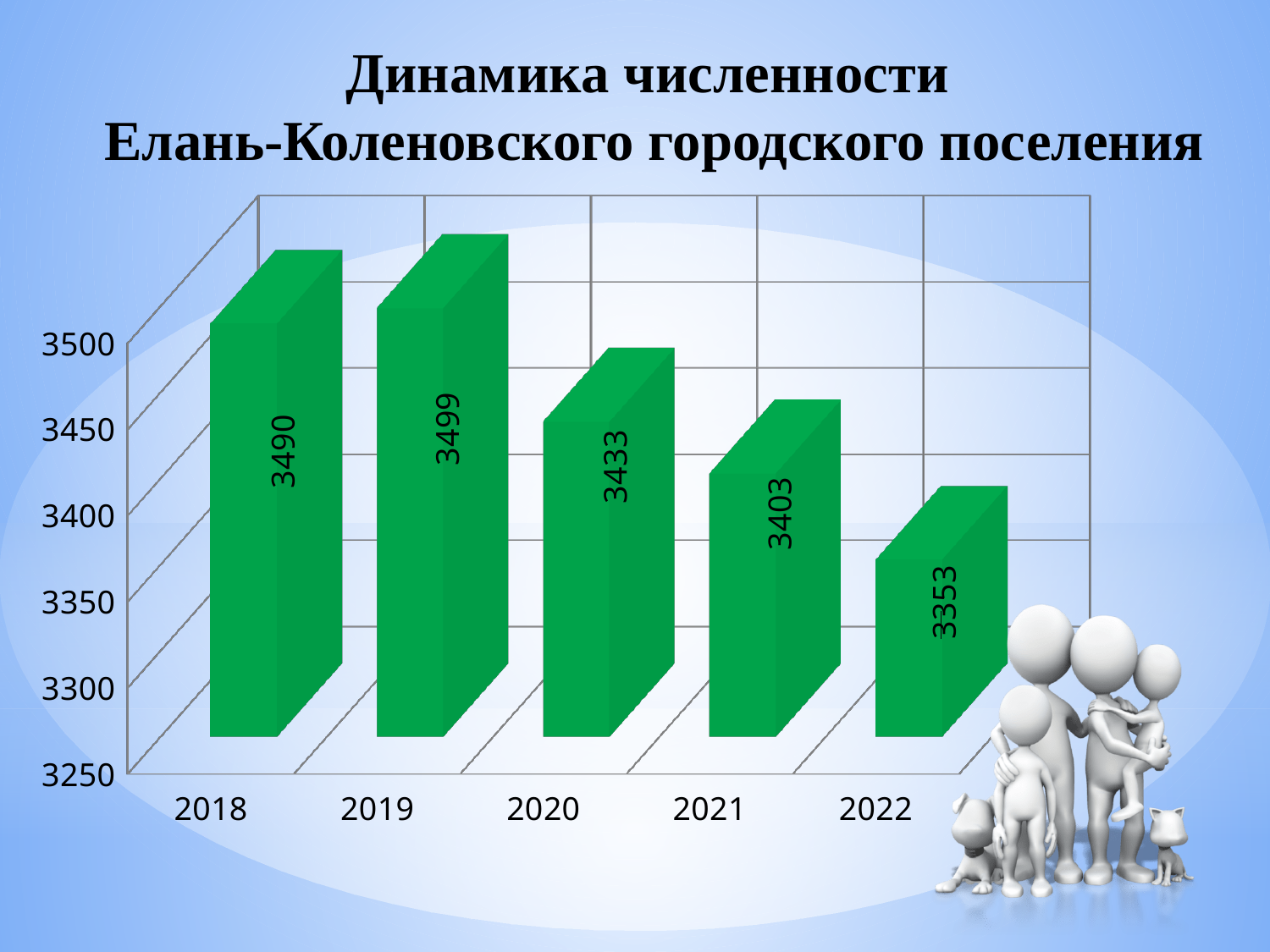
How many years are shown on the chart? 5 What kind of chart is shown on the slide? bar chart What is the difference between the values for 2020 and 2021? 30 What is the population value shown for 2022? 3353 Which year has the highest value? 2019 Which year has the lowest value? 2022 Do the values generally rise or fall from 2019 to 2022? fall What is the population value shown for 2018? 3490 What is the difference between the values for 2019 and 2022? 146 Which is larger, the value for 2018 or the value for 2020? 2018 What is the value shown for 2020? 3433 Is the value for 2021 greater or less than 3450? less